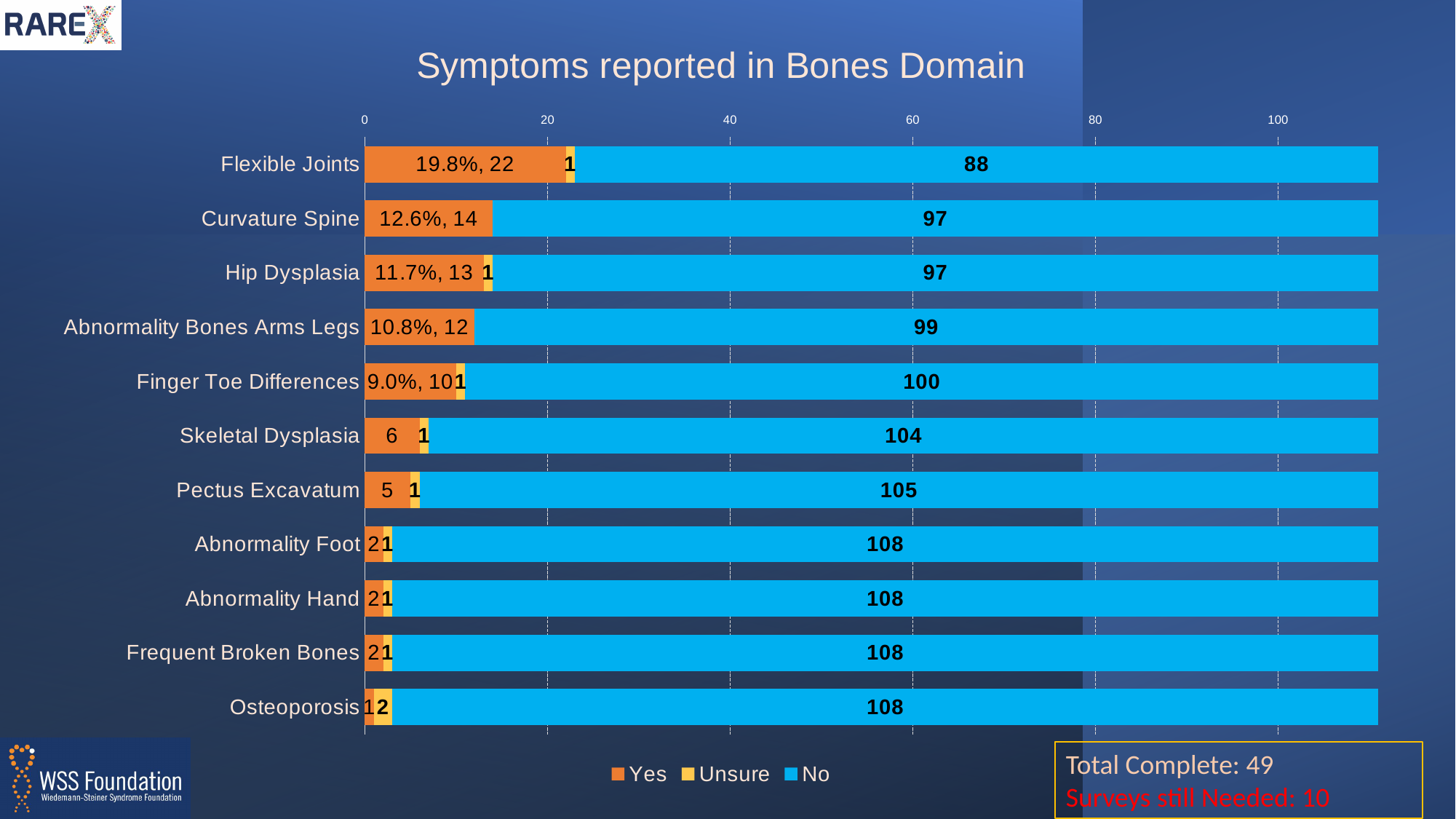
How many people answered No for Flexible Joints? 88 What is the Unsure value for Osteoporosis? 2 What is the Yes count for Curvature Spine? 14 How many series does the legend list? 3 What is the total of the Skeletal Dysplasia bar (Yes + Unsure + No)? 111 Which symptom has the lowest No count? Flexible Joints How many symptoms are listed on the chart? 11 What is the difference between the No counts for Curvature Spine and Flexible Joints? 9 Which symptom has the highest Yes count? Flexible Joints Which has a larger Yes count, Hip Dysplasia or Abnormality Bones Arms Legs? Hip Dysplasia What kind of chart is shown? Stacked bar chart What percentage is shown for Yes on Flexible Joints? 19.8%